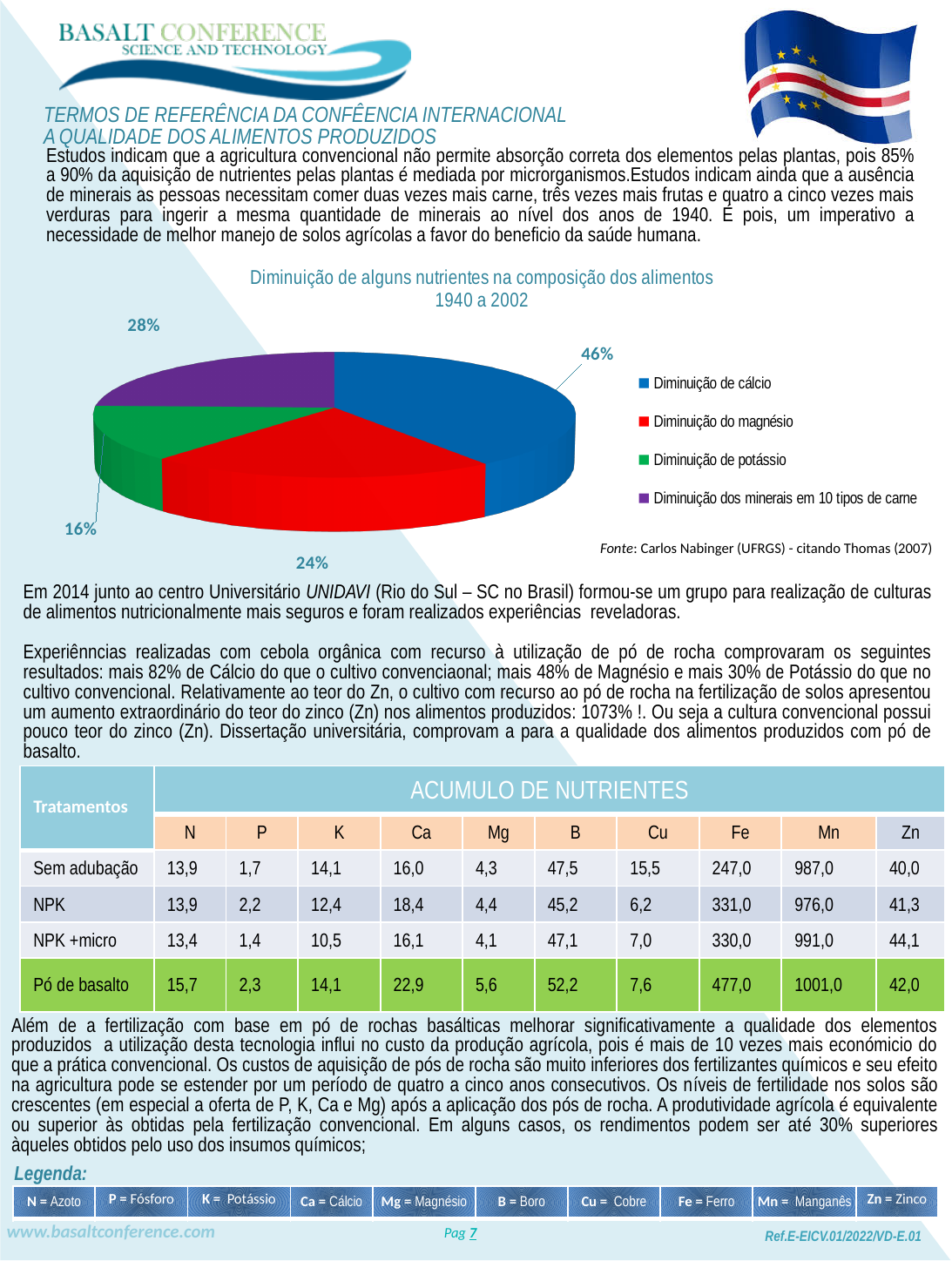
Which slice of the pie chart has the largest percentage? Diminuição de cálcio How many entries does the legend of the pie chart list? 4 What percentage is shown for 'Diminuição dos minerais em 10 tipos de carne' in the pie chart? 28% What is the title of the pie chart? Diminuição de alguns nutrientes na composição dos alimentos 1940 a 2002 What percentage is shown for 'Diminuição do magnésio' in the pie chart? 24% What percentage is shown for 'Diminuição de cálcio' in the pie chart? 46% Which is larger in the pie chart: 'Diminuição do magnésio' or 'Diminuição dos minerais em 10 tipos de carne'? Diminuição dos minerais em 10 tipos de carne What kind of chart is shown on the slide? pie chart What percentage is shown for 'Diminuição de potássio' in the pie chart? 16% How many slices does the pie chart have? 4 What colour is the 'Diminuição de potássio' slice in the pie chart? green Which slice of the pie chart has the smallest percentage? Diminuição de potássio